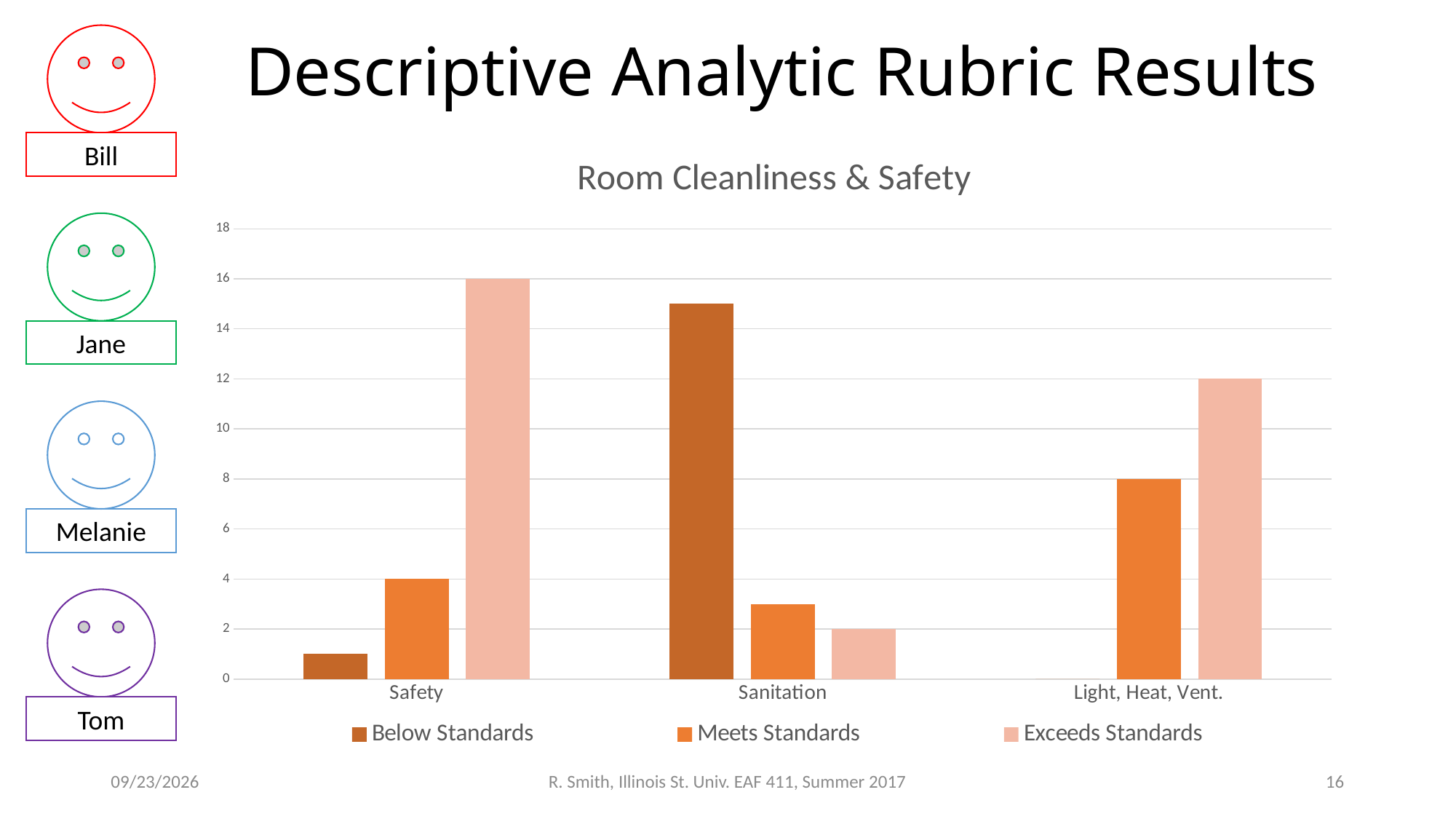
Which category has the highest Below Standards value? Sanitation What is the difference between Exceeds Standards and Meets Standards for Safety? 12 What kind of chart is shown on the slide? bar chart What is the value of Meets Standards for Light, Heat, Vent.? 8 What is the title of the chart? Room Cleanliness & Safety What is the value of Exceeds Standards for Safety? 16 What is the value of Exceeds Standards for Sanitation? 2 Which category has the lowest Exceeds Standards value? Sanitation How many series does the legend list? 3 How many categories are shown on the x axis? 3 Is the value of Below Standards for Safety greater or less than 2? less Is the value of Below Standards for Sanitation greater or less than 14? greater